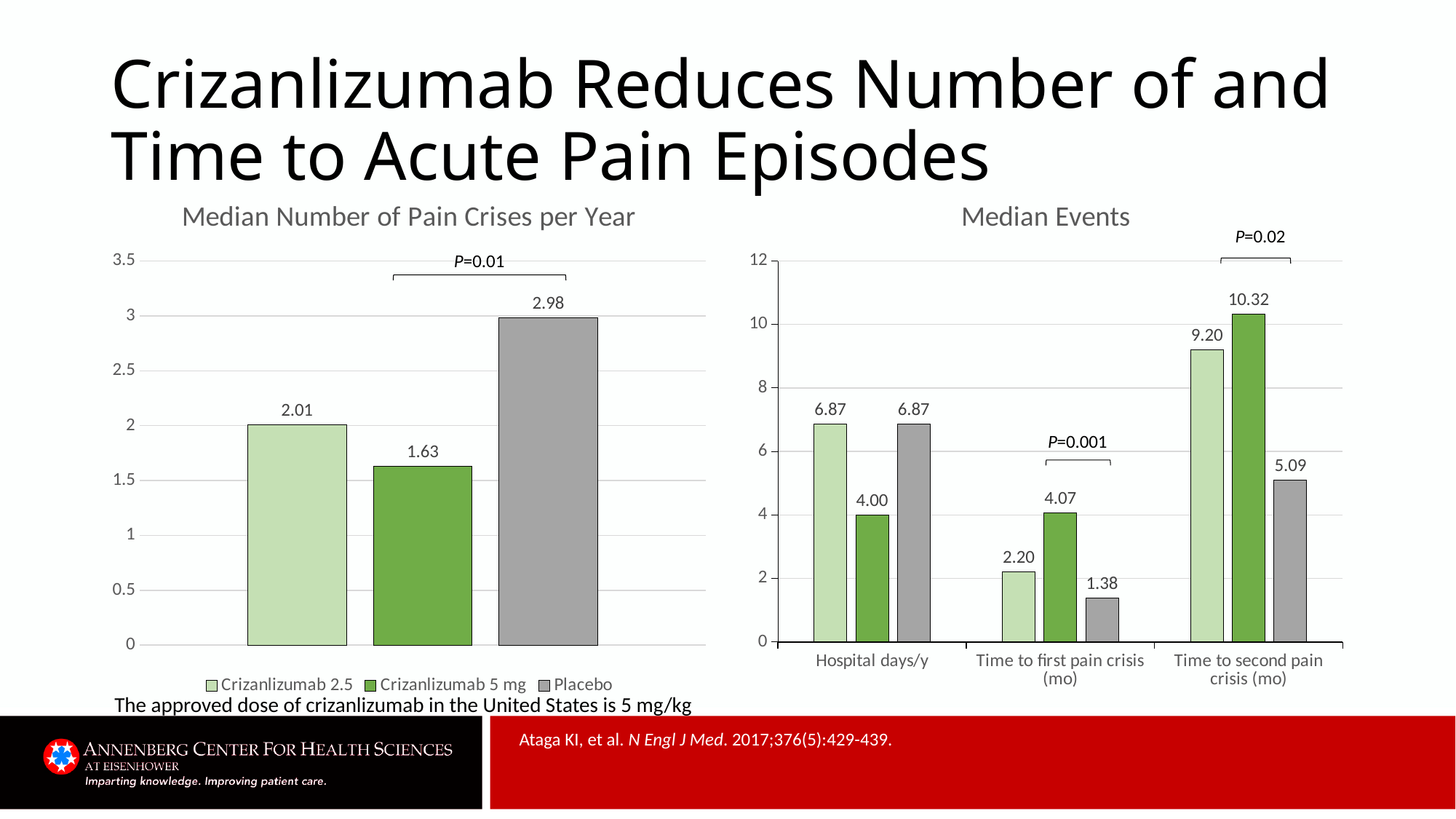
In the 'Median Number of Pain Crises per Year' chart, what is the value for Crizanlizumab 5 mg? 1.63 In the 'Median Events' chart, which series has the highest value for Hospital days/y? Crizanlizumab 2.5 and Placebo (both 6.87) In the 'Median Number of Pain Crises per Year' chart, what is the difference between the Placebo and Crizanlizumab 5 mg values? 1.35 In the 'Median Events' chart, what is the Placebo value for Time to first pain crisis (mo)? 1.38 How many categories are shown on the x axis of the 'Median Events' chart? 3 How many series does the legend list for the 'Median Number of Pain Crises per Year' chart? 3 In the 'Median Number of Pain Crises per Year' chart, what is the value for Placebo? 2.98 In the 'Median Events' chart, is the Crizanlizumab 5 mg value for Hospital days/y larger or smaller than the Placebo value? smaller In the 'Median Events' chart, what is the difference between the Crizanlizumab 5 mg and Placebo values for Time to second pain crisis (mo)? 5.23 What type of chart is the 'Median Events' chart? bar chart In the 'Median Events' chart, what is the value for Crizanlizumab 5 mg for Time to second pain crisis (mo)? 10.32 In the 'Median Number of Pain Crises per Year' chart, which group has the lowest value? Crizanlizumab 5 mg